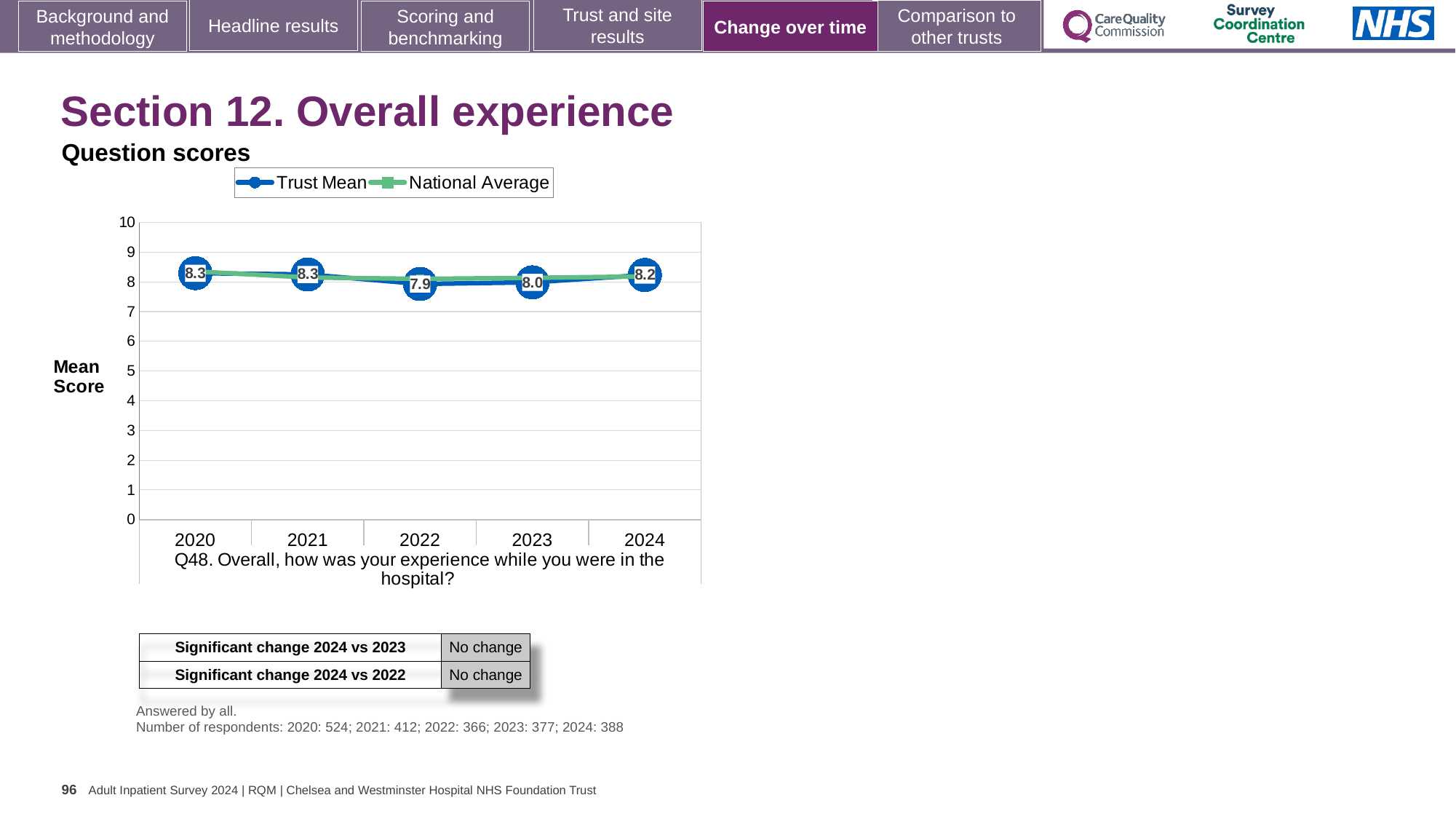
Which year has the higher Trust Mean score, 2021 or 2022? 2021 What is the Trust Mean score for 2024? 8.2 What is the Trust Mean score for 2022? 7.9 Does the Trust Mean score rise or fall from 2022 to 2024? rise What kind of chart is shown on the slide? line chart What is the difference between the Trust Mean scores for 2024 and 2023? 0.2 How many series does the legend list? 2 How many years are plotted on the x axis? 5 What is the difference between the Trust Mean scores for 2020 and 2022? 0.4 What is the Trust Mean score for 2020? 8.3 In which year is the Trust Mean score lowest? 2022 Is the National Average value for 2022 greater or less than 7? greater